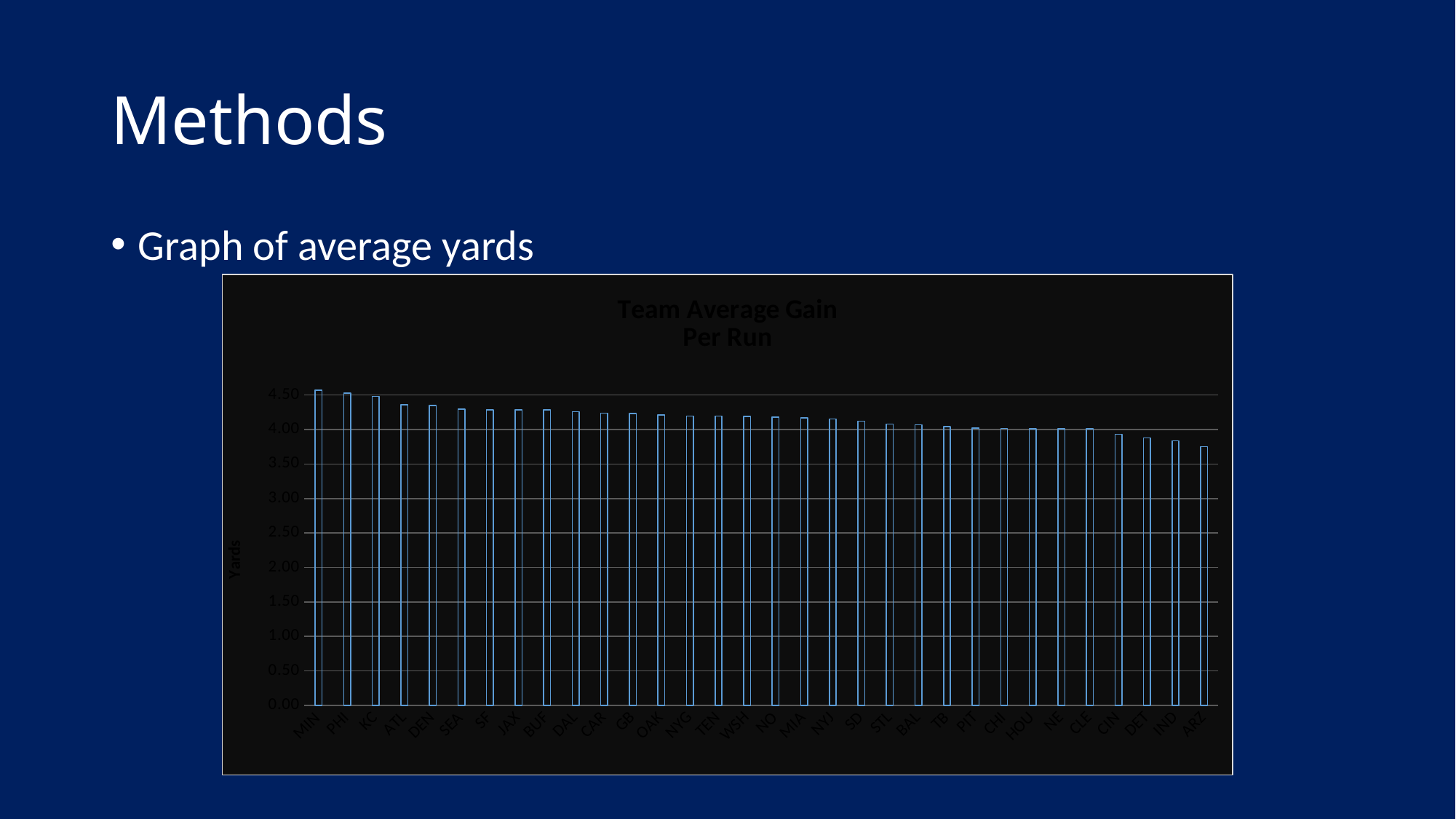
How many teams are plotted on the chart? 32 What is the label on the vertical axis of the chart? Yards Which has the larger average gain per run, PHI or IND? PHI Which team has the highest average gain per run? MIN What kind of chart is shown on the slide? bar chart Is the value for ARZ greater or less than 4.00? less Do the values rise or fall moving from left to right along the x axis? fall Which team has the lowest average gain per run? ARZ Is the value for MIN greater or less than 4.00? greater Is the value for IND greater or less than 4.00? less What is the title of the chart? Team Average Gain Per Run